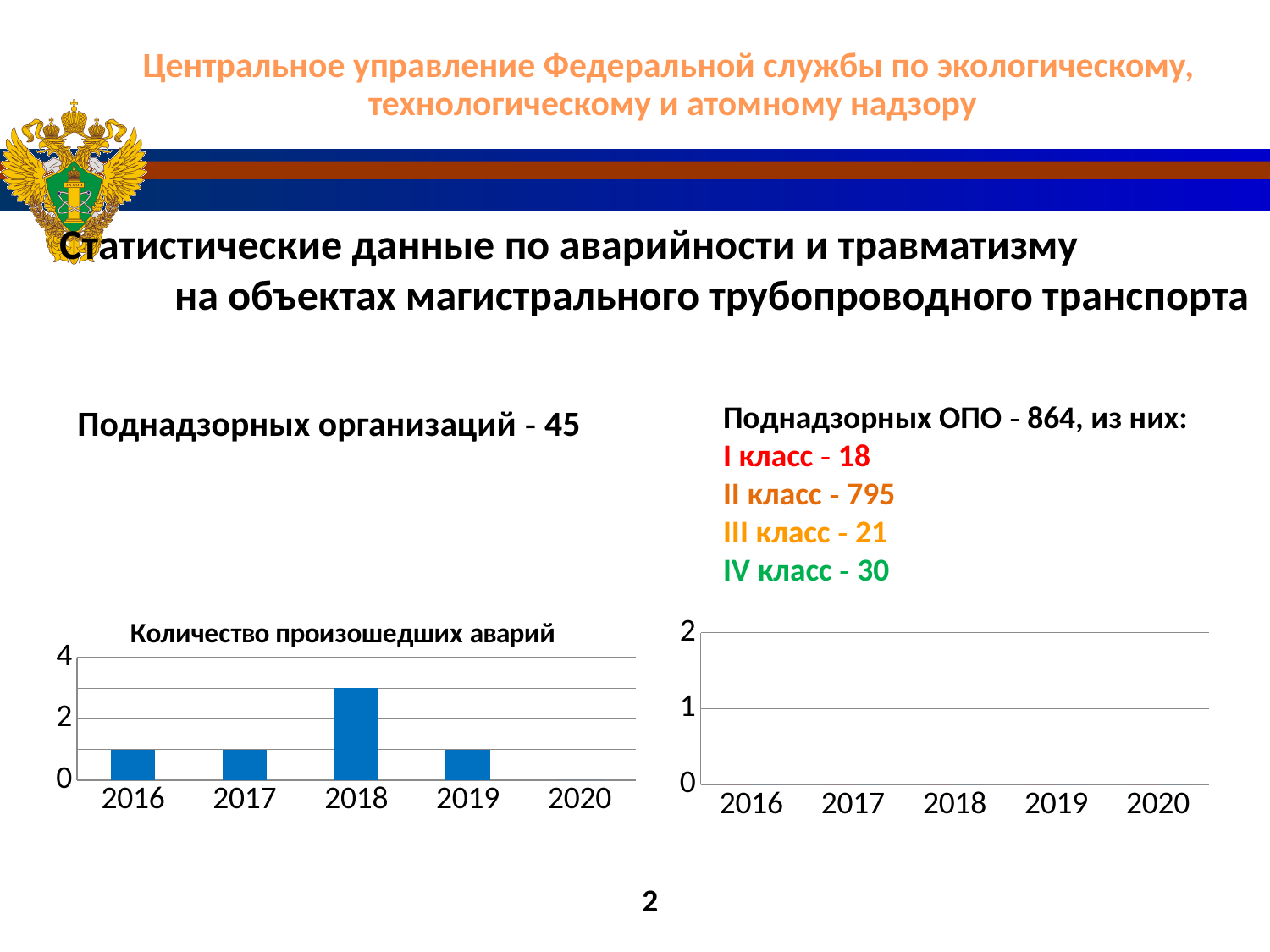
How many years are shown on the x axis of the chart on the right side of the slide? 5 In the chart titled "Количество произошедших аварий", which is larger, the value for 2018 or the value for 2017? 2018 In the chart titled "Количество произошедших аварий", is the value for 2019 greater or less than 2? less In the chart titled "Количество произошедших аварий", is the value for 2016 greater or less than 2? less In the chart titled "Количество произошедших аварий", which year has the highest value? 2018 In the chart titled "Количество произошедших аварий", which year has no bar at all? 2020 How many years are shown on the x axis of the chart titled "Количество произошедших аварий"? 5 In the chart titled "Количество произошедших аварий", is the value for 2018 greater or less than 2? greater What is the highest value shown on the y axis of the chart on the right side of the slide? 2 What is the highest value shown on the y axis of the chart titled "Количество произошедших аварий"? 4 In the chart titled "Количество произошедших аварий", do the values for 2016 and 2017 appear equal or different? equal What type of chart is the chart titled "Количество произошедших аварий"? bar chart